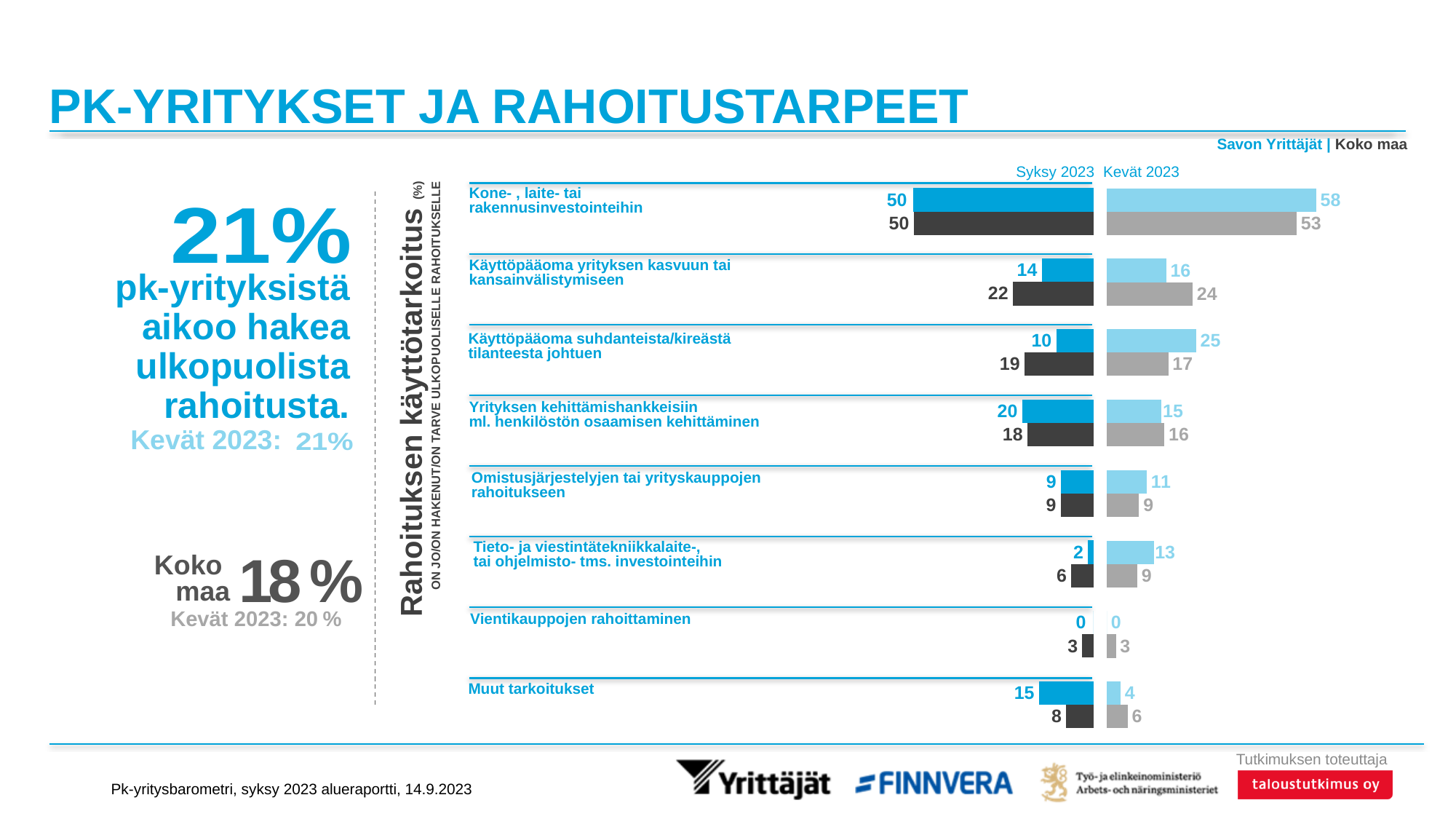
In the Syksy 2023 panel, what is the Koko maa value for 'Käyttöpääoma yrityksen kasvuun tai kansainvälistymiseen'? 22 In the Syksy 2023 panel, what is the value for Savon Yrittäjät for 'Kone-, laite- tai rakennusinvestointeihin'? 50 In the Syksy 2023 panel, what is the difference between the Koko maa value (19) and the Savon Yrittäjät value (10) for 'Käyttöpääoma suhdanteista/kireästä tilanteesta johtuen'? 9 In the Syksy 2023 panel, which category has the highest Savon Yrittäjät value? Kone-, laite- tai rakennusinvestointeihin How many categories (financing purposes) are listed in the chart? 8 In the Kevät 2023 panel, what is the difference between the Savon Yrittäjät value (13) and the Koko maa value (9) for 'Tieto- ja viestintätekniikkalaite-, tai ohjelmisto- tms. investointeihin'? 4 In the Syksy 2023 panel, which category has the lowest Savon Yrittäjät value? Vientikauppojen rahoittaminen In the Syksy 2023 panel, for 'Muut tarkoitukset', which is larger: the Savon Yrittäjät value or the Koko maa value? Savon Yrittäjät What are the two time periods shown as column headings above the chart? Syksy 2023 and Kevät 2023 What kind of chart is shown on the slide? bar chart In the Kevät 2023 panel, what is the Savon Yrittäjät value for 'Käyttöpääoma suhdanteista/kireästä tilanteesta johtuen'? 25 In the Kevät 2023 panel, what is the value for Savon Yrittäjät for 'Kone-, laite- tai rakennusinvestointeihin'? 58